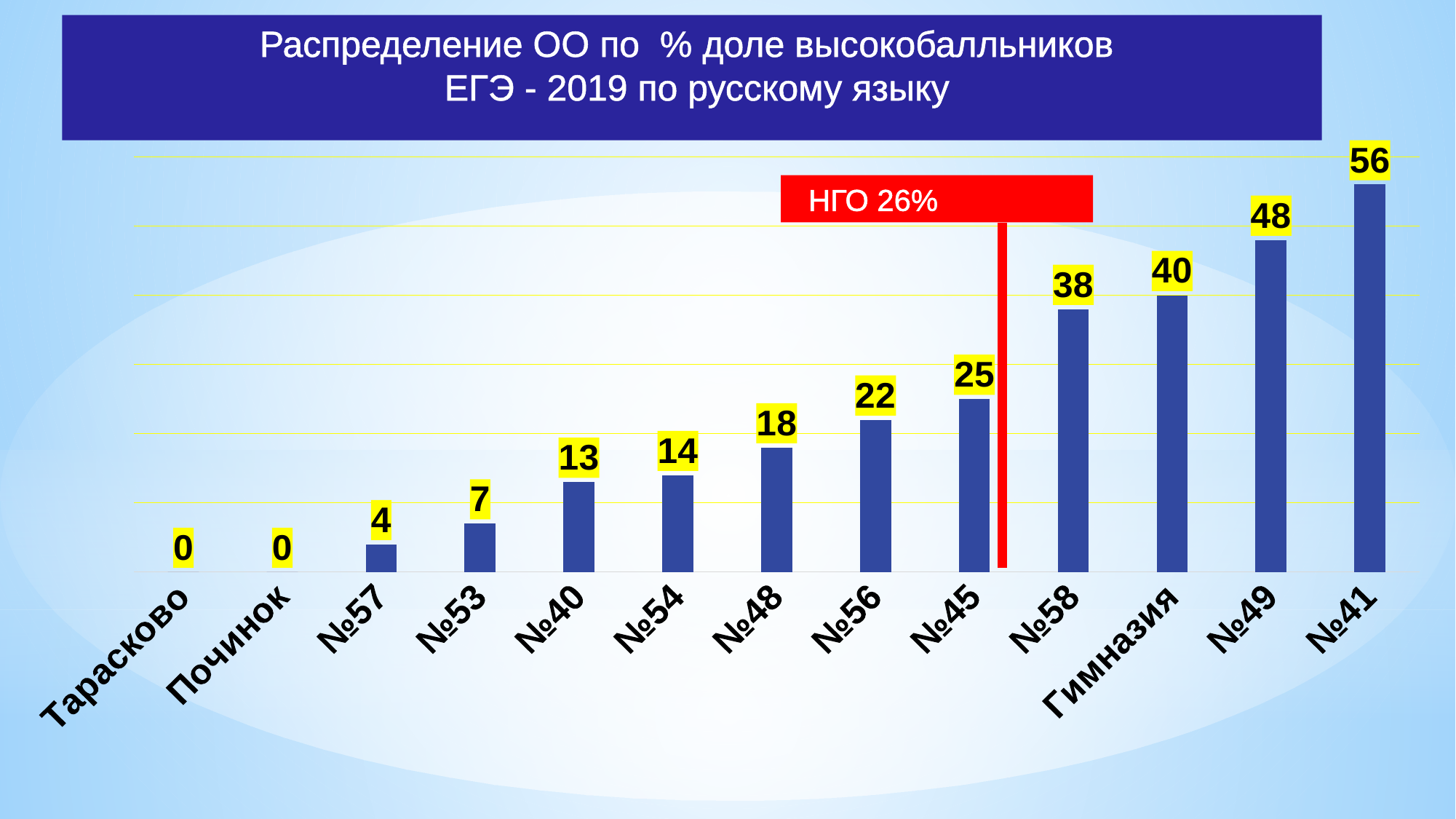
How many categories are shown on the x axis? 13 What is the difference between the values for №41 and №49? 8 What is the value for №53? 7 How many categories have a value of 0? 2 What is the difference between the values for №45 and №56? 3 What is the value for №58? 38 Which category has the highest value? №41 What value is shown in the red label on the chart? НГО 26% Do the values rise or fall from left to right along the x axis? rise Which is larger, the value for №54 or the value for №40? №54 What is the value for Гимназия? 40 What kind of chart is shown on the slide? bar chart